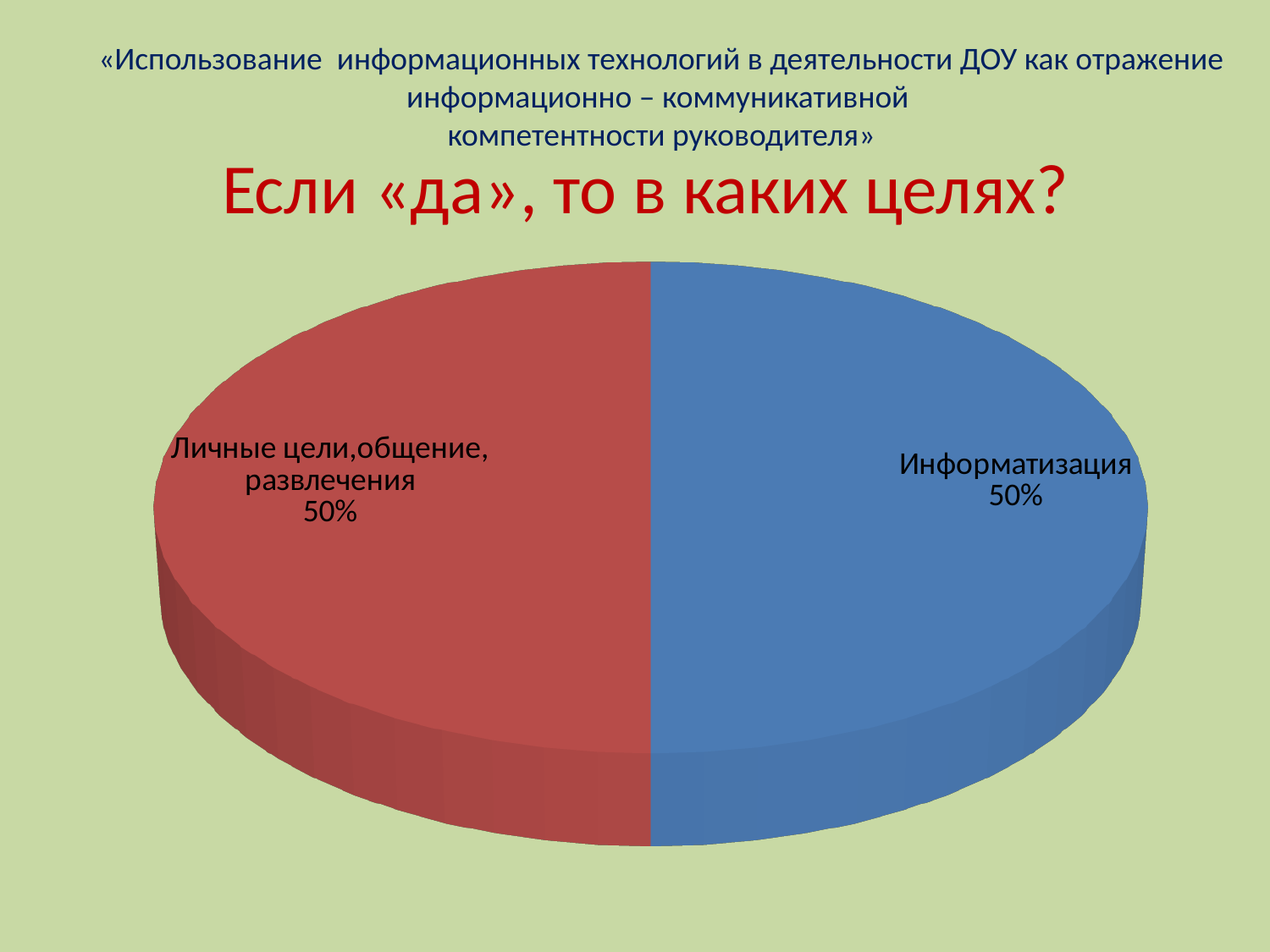
What is the difference between the values for "Информатизация" and "Личные цели,общение, развлечения"? 0% What is the value shown for "Информатизация"? 50% How many slices does the pie chart have? 2 What share of the pie does the "Личные цели,общение, развлечения" slice represent? 50% What share of the pie does the "Информатизация" slice represent? 50% What kind of chart is shown on the slide? pie chart What is the value shown for "Личные цели,общение, развлечения"? 50% What is the total of the two slices shown in the pie chart? 100% What colour is the "Информатизация" slice? blue What colour is the "Личные цели,общение, развлечения" slice? red